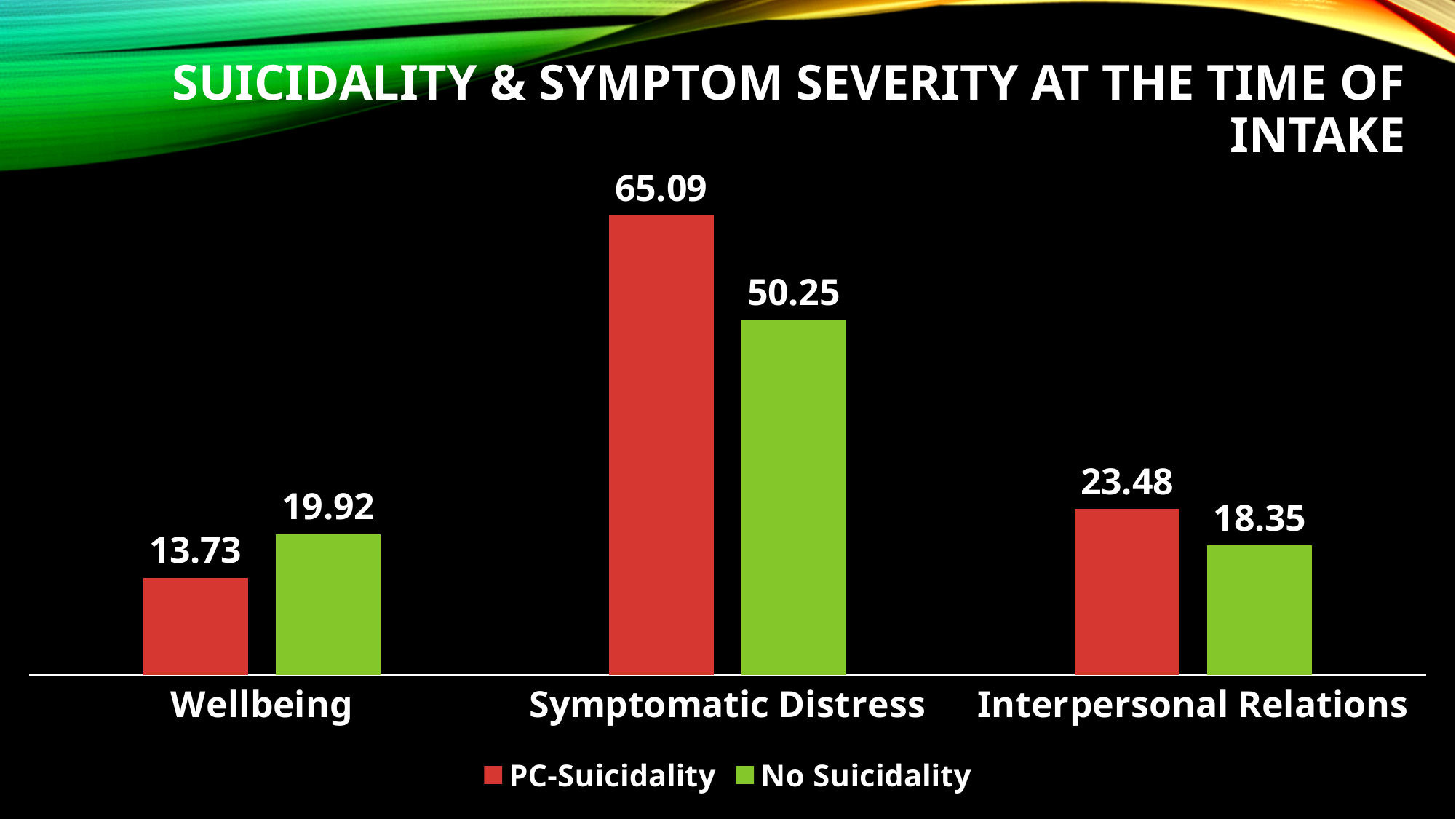
What is the No Suicidality value for Wellbeing? 19.92 What is the No Suicidality value for Symptomatic Distress? 50.25 How many categories are shown on the x axis? 3 What is the PC-Suicidality value for Wellbeing? 13.73 What is the PC-Suicidality value for Interpersonal Relations? 23.48 Which category has the highest PC-Suicidality value? Symptomatic Distress What is the difference between the PC-Suicidality and No Suicidality values for Symptomatic Distress? 14.84 For Wellbeing, which is larger: the PC-Suicidality value or the No Suicidality value? No Suicidality How many series does the legend list? 2 What kind of chart is shown on the slide? Bar chart Which colour represents the No Suicidality series? Green Which category has the lowest No Suicidality value? Interpersonal Relations